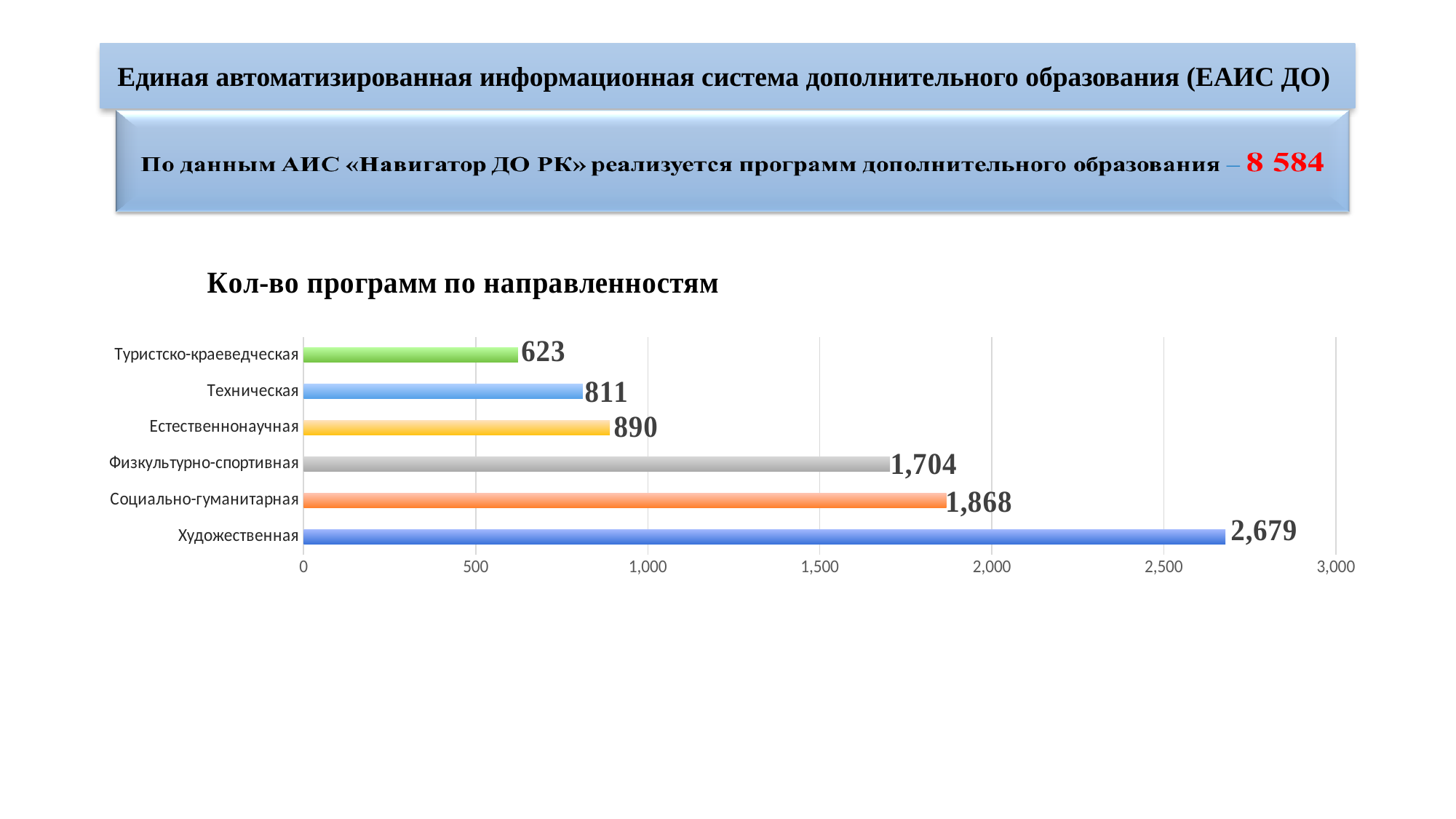
What is the difference between the values for Естественнонаучная and Техническая? 79 Which category has the highest value? Художественная What is the difference between the values for Социально-гуманитарная and Физкультурно-спортивная? 164 What kind of chart is shown on the slide? bar chart Which category has the lowest value? Туристско-краеведческая What is the value for Туристско-краеведческая? 623 What is the value for Художественная? 2,679 Is the value for Социально-гуманитарная greater or less than 1,500? greater How many categories are shown in the chart? 6 What is the value for Физкультурно-спортивная? 1,704 What is the title of the chart? Кол-во программ по направленностям Which is larger, the value for Техническая or the value for Естественнонаучная? Естественнонаучная